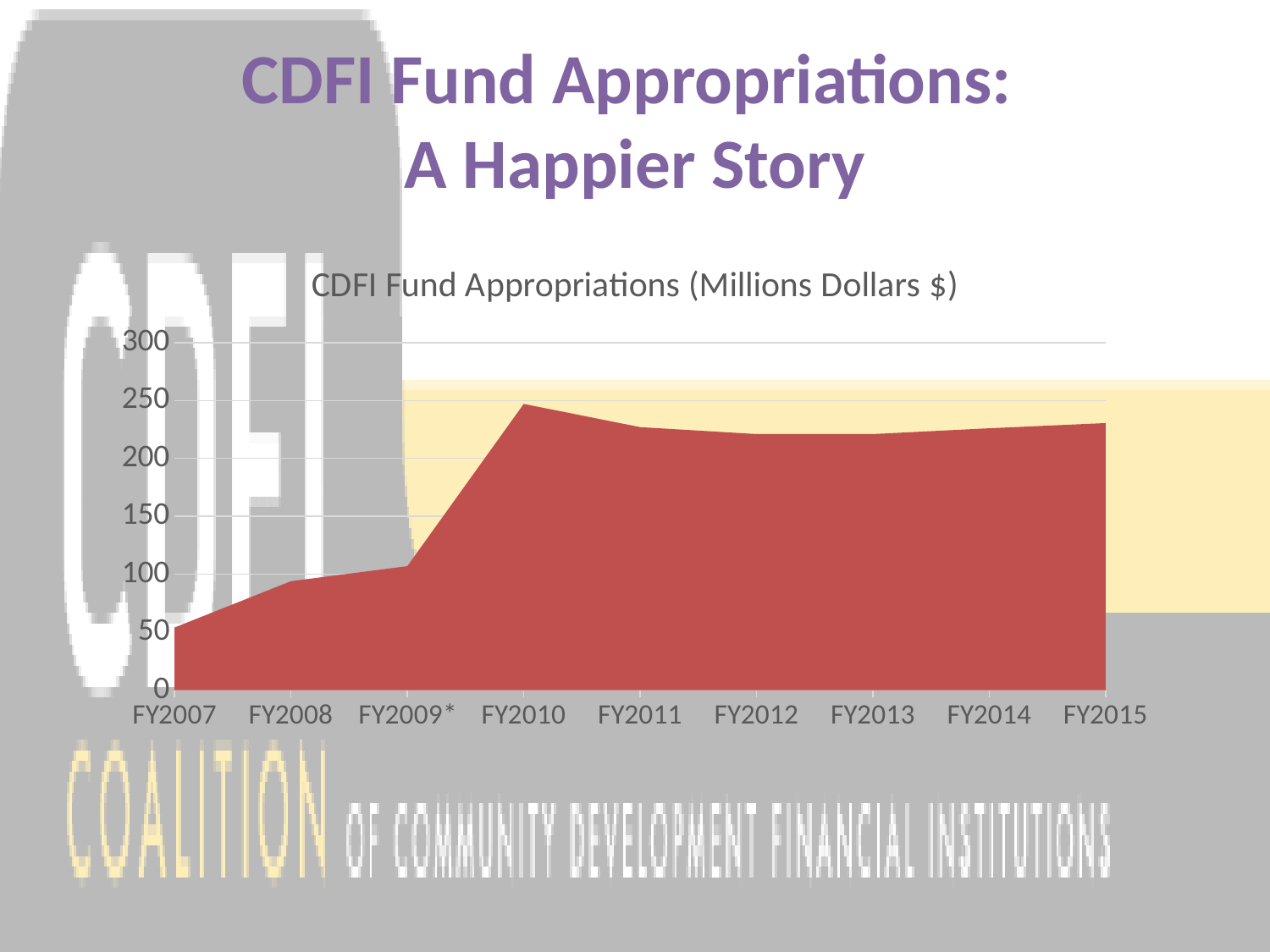
Do the values rise or fall from FY2007 to FY2010? rise Which fiscal year has the lowest appropriation? FY2007 Which is larger, the value for FY2008 or the value for FY2011? FY2011 What is the highest value shown on the y axis? 300 Is the value for FY2010 greater or less than 200? greater What kind of chart is shown on the slide? area chart What is the title of the chart? CDFI Fund Appropriations (Millions Dollars $) Is the value for FY2009* greater or less than 150? less Is the value for FY2007 greater or less than 100? less Which fiscal year has the highest appropriation? FY2010 How many fiscal years are plotted on the x axis? 9